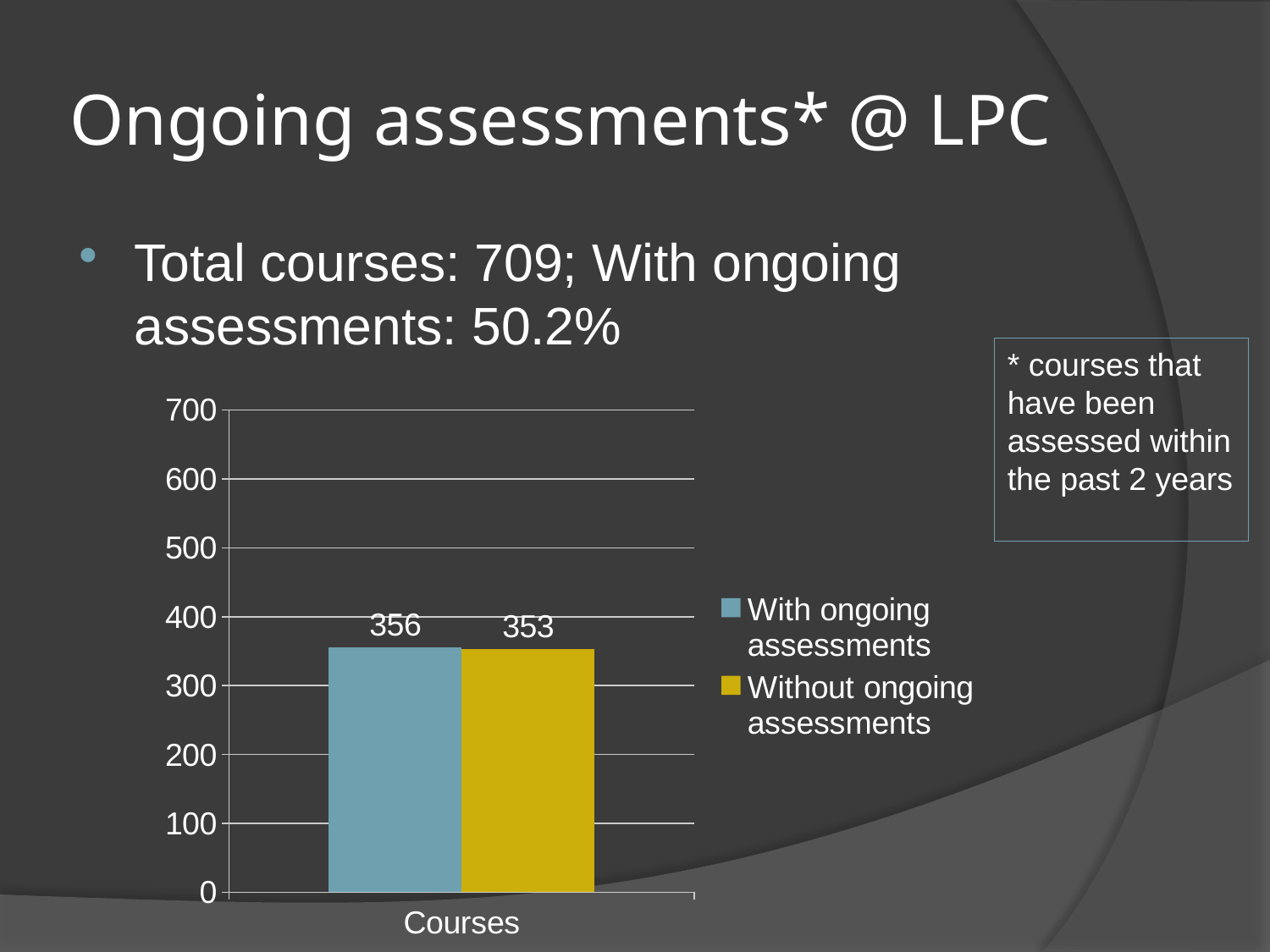
What kind of chart is shown on the slide? bar chart What is the value for 'Without ongoing assessments'? 353 What is the value for 'With ongoing assessments'? 356 What is the category label shown on the x axis? Courses How many categories are shown on the x axis? 1 What is the difference between the 'With ongoing assessments' and 'Without ongoing assessments' values? 3 Is the value for 'With ongoing assessments' greater or less than 400? less What is the total of the two bars shown in the chart? 709 Is the value for 'Without ongoing assessments' greater or less than 300? greater What colour is the bar for 'Without ongoing assessments'? yellow What is the highest value shown on the y axis? 700 How many series does the legend list? 2